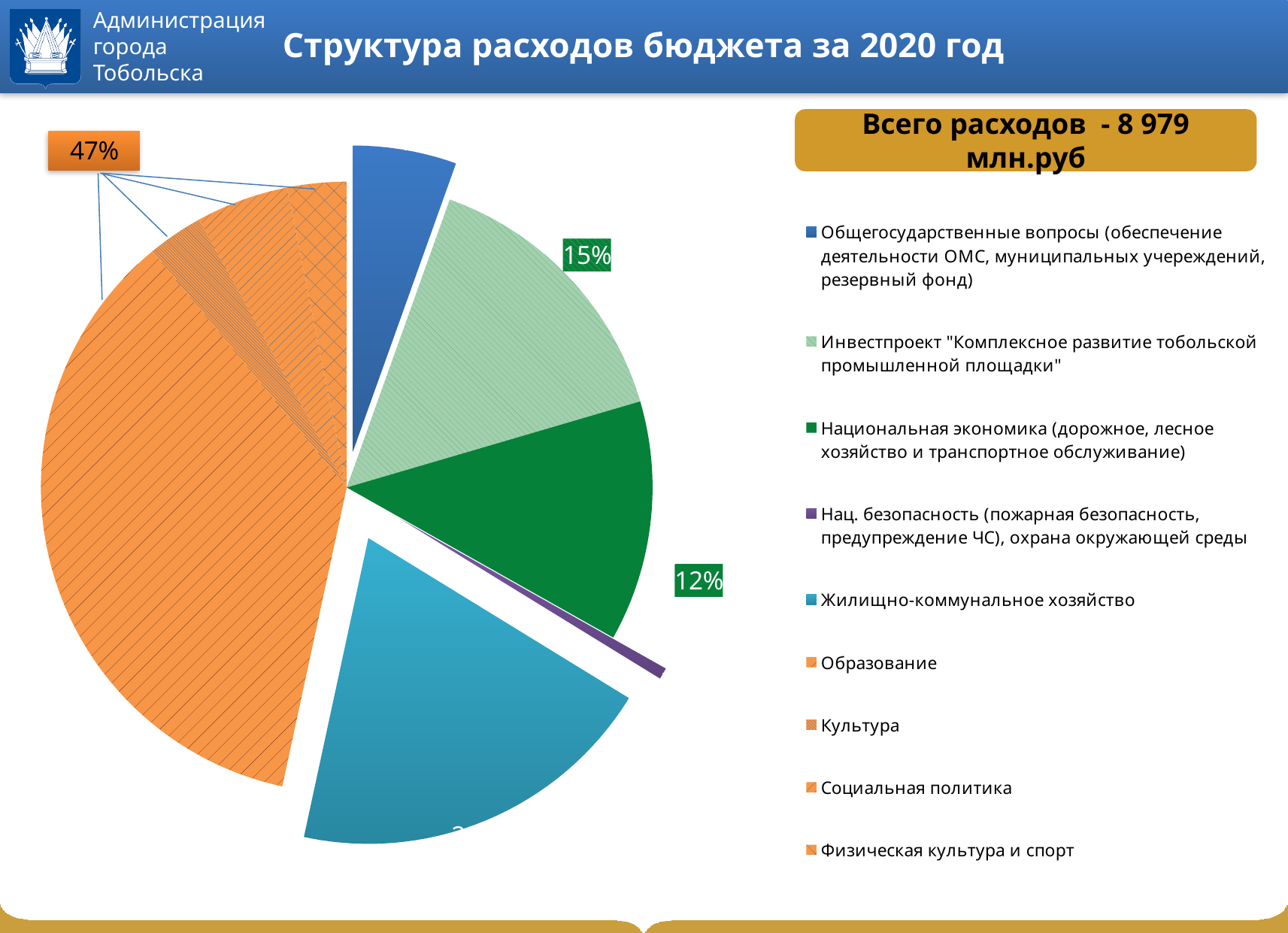
How many categories does the chart's legend list? 9 Which is larger: the share for Инвестпроект "Комплексное развитие тобольской промышленной площадки" or the share for Национальная экономика? Инвестпроект "Комплексное развитие тобольской промышленной площадки" What share of the budget expenses is labelled for Национальная экономика (дорожное, лесное хозяйство и транспортное обслуживание)? 12% What share of the budget expenses is labelled for Инвестпроект "Комплексное развитие тобольской промышленной площадки"? 15% What is the title of the chart on the slide? Структура расходов бюджета за 2020 год What kind of chart is shown on the slide? pie chart Which category has the largest slice of the pie? Образование By how many percentage points does the share for Инвестпроект exceed the share for Национальная экономика? 3 percentage points Which category has the smallest slice of the pie? Нац. безопасность (пожарная безопасность, предупреждение ЧС), охрана окружающей среды What total amount of expenses is stated on the slide next to the chart? 8 979 млн.руб Which slice is larger: Общегосударственные вопросы or Инвестпроект "Комплексное развитие тобольской промышленной площадки"? Инвестпроект "Комплексное развитие тобольской промышленной площадки" Which slice is larger: Жилищно-коммунальное хозяйство or Национальная экономика? Жилищно-коммунальное хозяйство